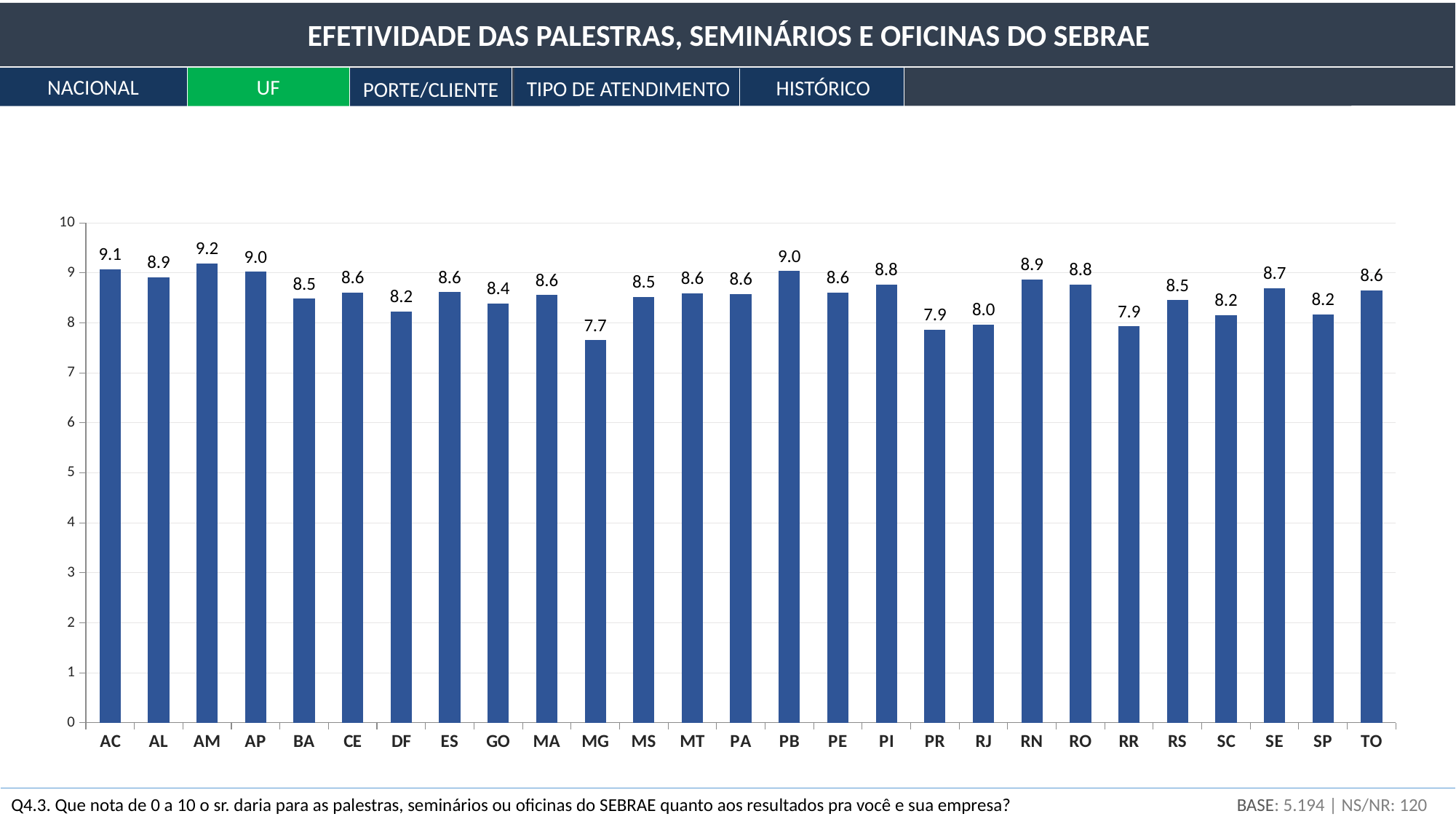
What is the value for AM? 9.2 What is the title of the slide? EFETIVIDADE DAS PALESTRAS, SEMINÁRIOS E OFICINAS DO SEBRAE What is the difference between the values for AM and MG? 1.5 Which is larger, the value for PI or the value for RJ? PI What is the value for PB? 9.0 What is the value for MG? 7.7 How many states are shown on the x axis? 27 Which state has the highest value? AM What is the difference between the values for AC and DF? 0.9 What kind of chart is shown on the slide? Bar chart What is the value for SE? 8.7 Which state has the lowest value? MG